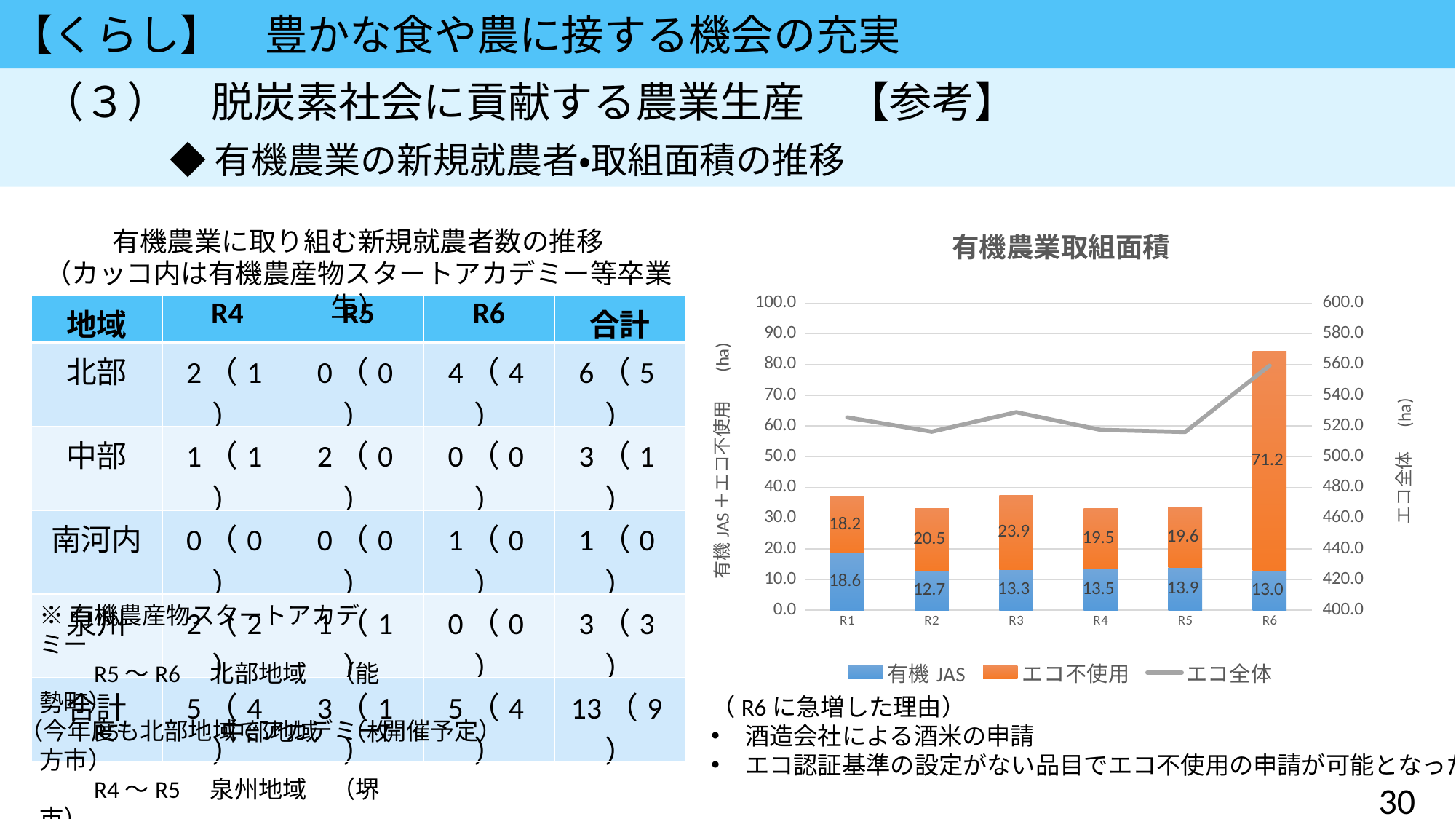
In the 有機農業取組面積 chart, is the エコ全体 value for R6 greater or less than 540.0? greater In the 有機農業取組面積 chart, what is the value of エコ不使用 for R6? 71.2 What is the title of the chart on the right side of the slide? 有機農業取組面積 What kind of chart is the 有機農業取組面積 chart? combination stacked bar and line chart In the 有機農業取組面積 chart, what is the total of the stacked bar for R3? 37.2 How many series does the legend of the 有機農業取組面積 chart list? 3 In the 有機農業取組面積 chart, what is the value of 有機 JAS for R1? 18.6 In the 有機農業取組面積 chart, which is larger, the 有機 JAS value for R1 or for R6? R1 In the 有機農業取組面積 chart, what is the difference between the エコ不使用 values for R6 and R5? 51.6 How many years are shown on the x axis of the 有機農業取組面積 chart? 6 In the 有機農業取組面積 chart, which year has the lowest 有機 JAS value? R2 In the 有機農業取組面積 chart, which year has the highest エコ不使用 value? R6